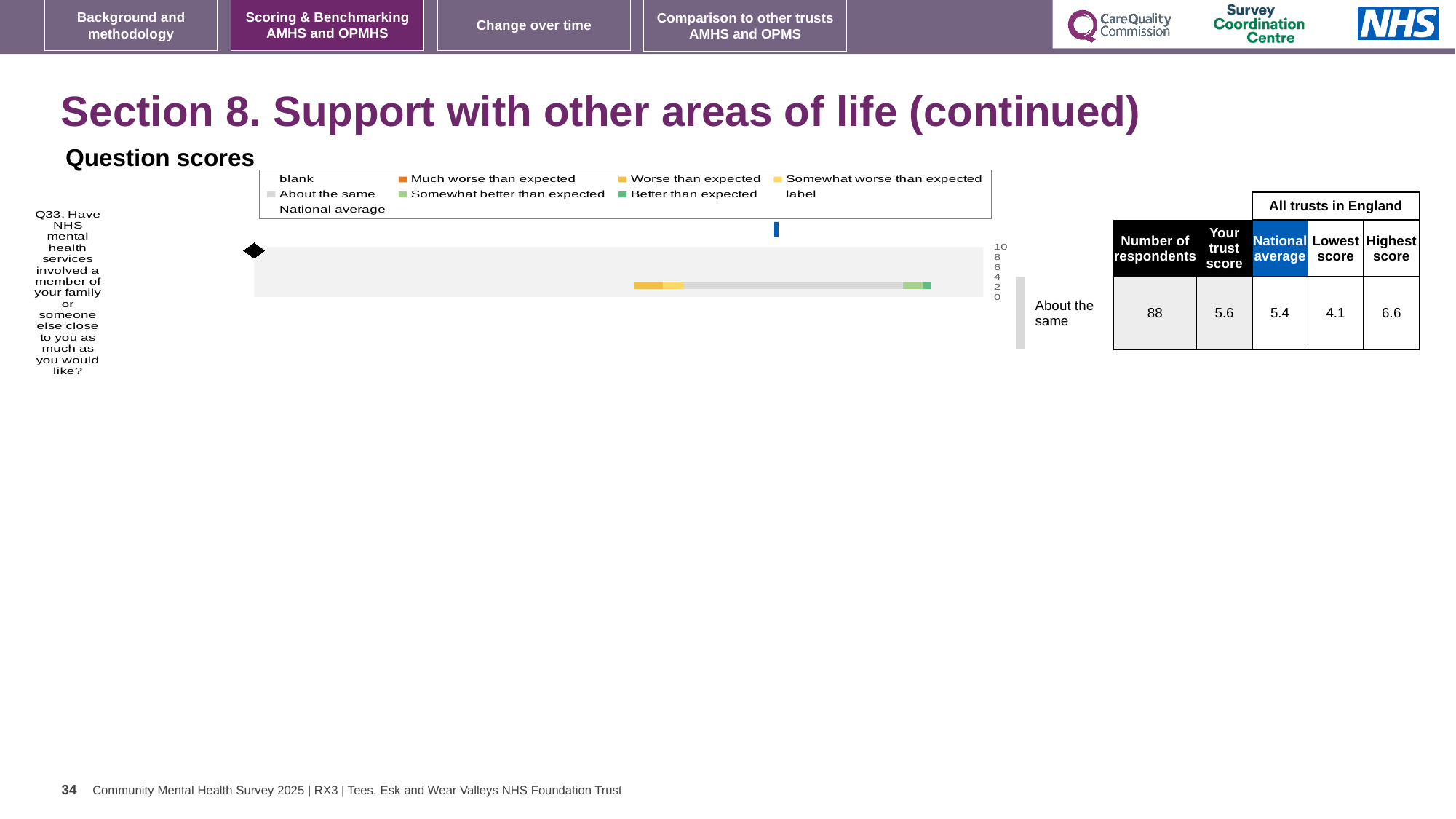
What rating category is shown for Q33 to the right of the chart? About the same Which question number is plotted in the chart? Q33 For Q33, what is the difference between the highest score and the lowest score among all trusts in England? 2.5 What kind of chart is used to show the Q33 question score? bar chart In the table beside the chart, what is the national average for Q33? 5.4 For Q33, which is larger: the trust's score or the national average? the trust's score In the table beside the chart, what is the highest score among all trusts in England for Q33? 6.6 In the table beside the chart, how many respondents answered Q33? 88 Which legend entry is shown in dark green? Better than expected In the table beside the chart, what is the trust's score for Q33? 5.6 In the table beside the chart, what is the lowest score among all trusts in England for Q33? 4.1 How many survey questions are plotted in the chart? 1